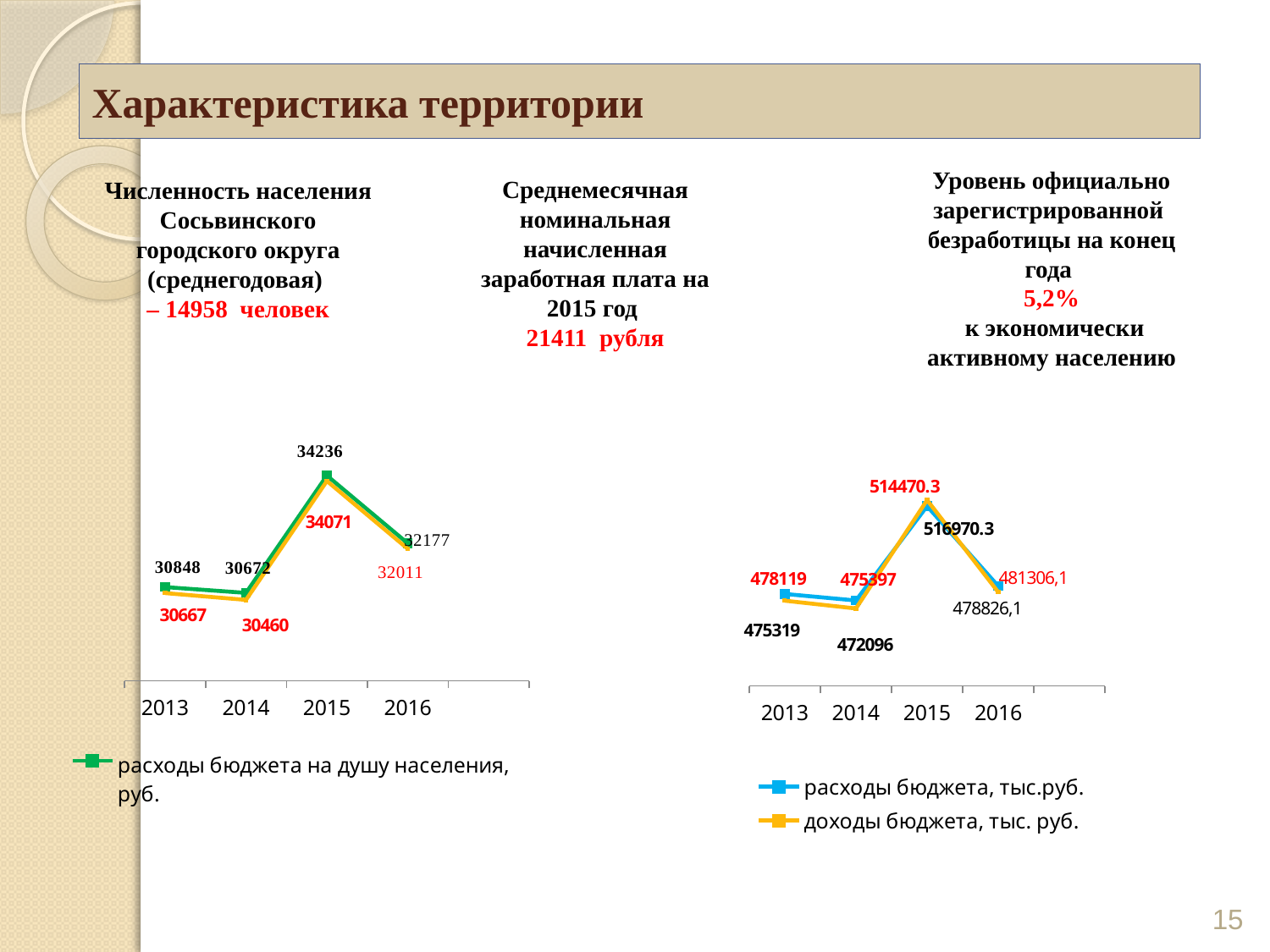
On the left chart, what is the difference between the 2015 and 2014 values of расходы бюджета на душу населения? 3564 How many series does the legend of the right chart list? 2 On the left chart, is the 2016 value of расходы бюджета на душу населения larger or smaller than the 2015 value? smaller What is the legend entry of the left chart? расходы бюджета на душу населения, руб. How many years are shown on the x axis of the left chart? 4 On the left chart, in which year does расходы бюджета на душу населения reach its highest value? 2015 On the right chart, do the values rise or fall from 2013 to 2014? fall On the left chart, what is the value of расходы бюджета на душу населения in 2013? 30848 On the left chart, in which year is расходы бюджета на душу населения lowest? 2014 On the left chart, what is the value of расходы бюджета на душу населения in 2015? 34236 What type of chart is the right chart? line chart On the right chart, in which year do both series reach their peak? 2015